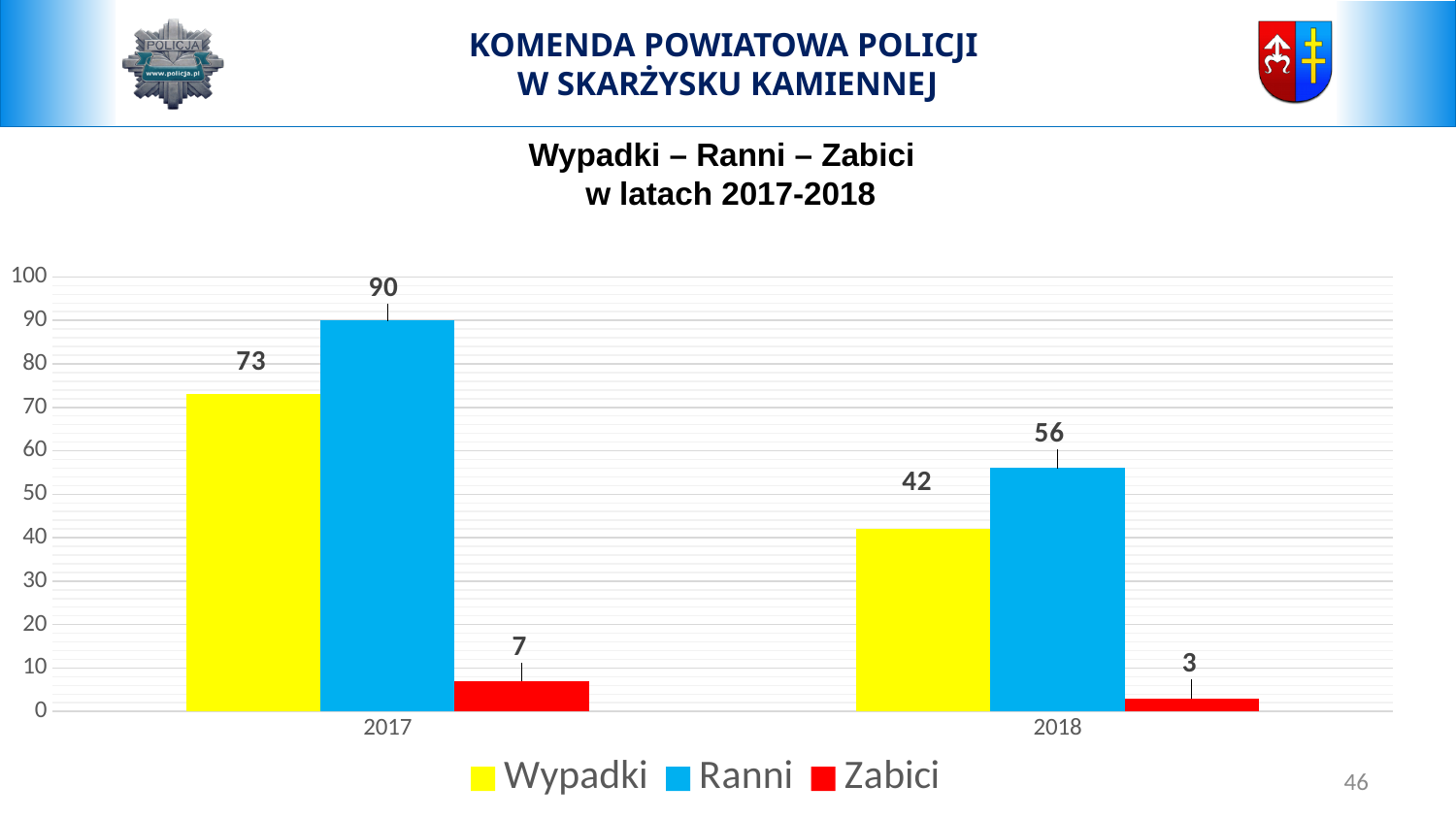
Does the value of Zabici rise or fall from 2017 to 2018? fall What is the value of Ranni in 2018? 56 How many years are shown on the x axis? 2 Which is larger: Wypadki in 2017 or Wypadki in 2018? Wypadki in 2017 Which series has the lowest value in 2018? Zabici What is the value of Wypadki in 2017? 73 What is the value of Zabici in 2017? 7 How many series does the legend list? 3 What is the difference between Ranni in 2017 and Ranni in 2018? 34 What is the difference between Wypadki and Zabici in 2018? 39 What kind of chart is shown on the slide? bar chart Which series has the highest value in 2017? Ranni